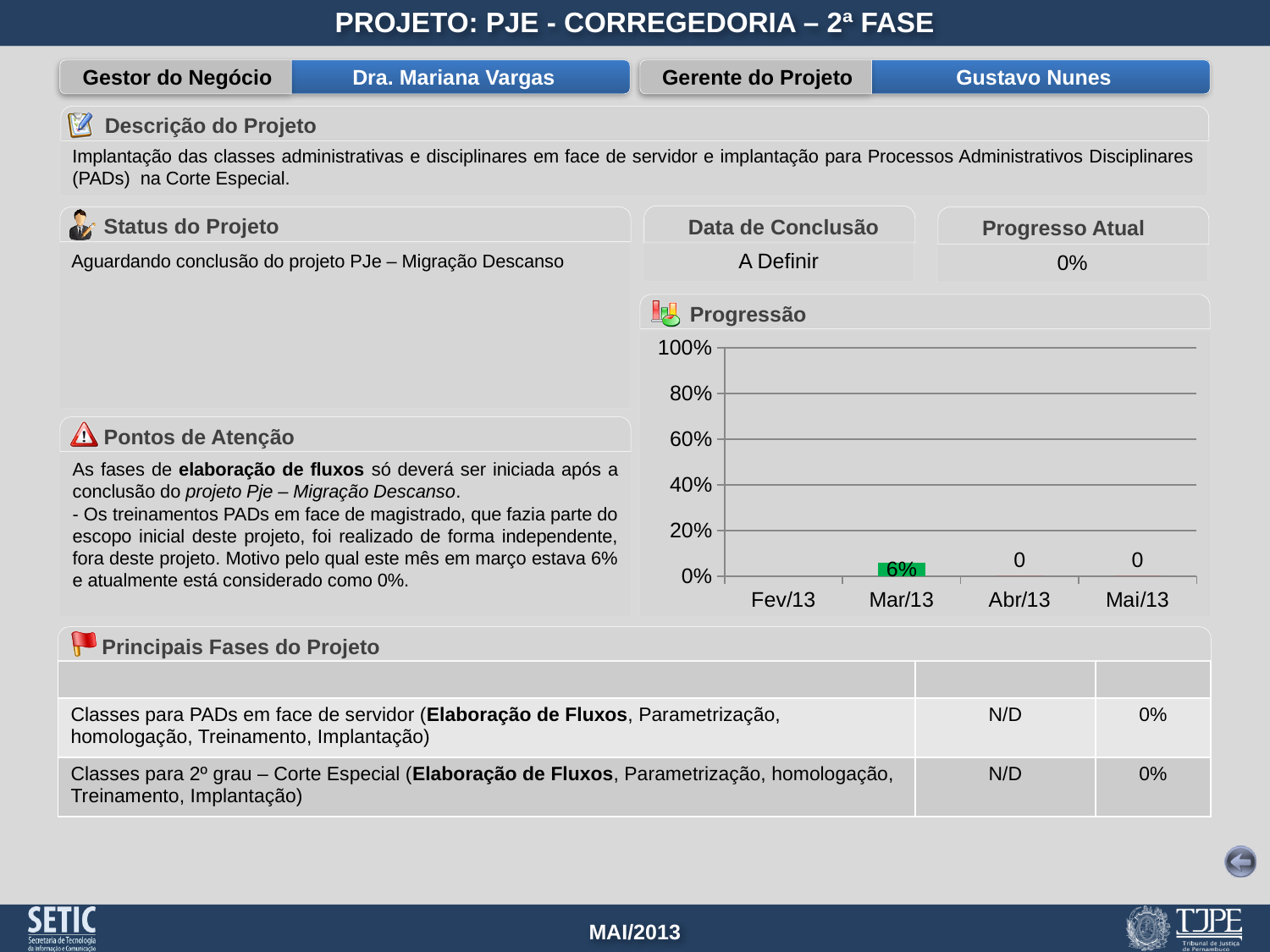
In the "Progressão" chart, which is larger, the value for Mar/13 or the value for Abr/13? Mar/13 In the "Progressão" chart, what is the value for Mar/13? 6% What type of chart is shown under "Progressão"? bar chart In the "Progressão" chart, which month has the highest value? Mar/13 How many months are shown on the x axis of the "Progressão" chart? 4 What is the title of the chart on the slide? Progressão In the "Progressão" chart, do the values rise or fall from Mar/13 to Abr/13? fall In the "Progressão" chart, what value is labelled for Mai/13? 0 What is the highest value shown on the y axis of the "Progressão" chart? 100% In the "Progressão" chart, is the value for Mar/13 greater or less than 20%? less In the "Progressão" chart, what value is labelled for Abr/13? 0